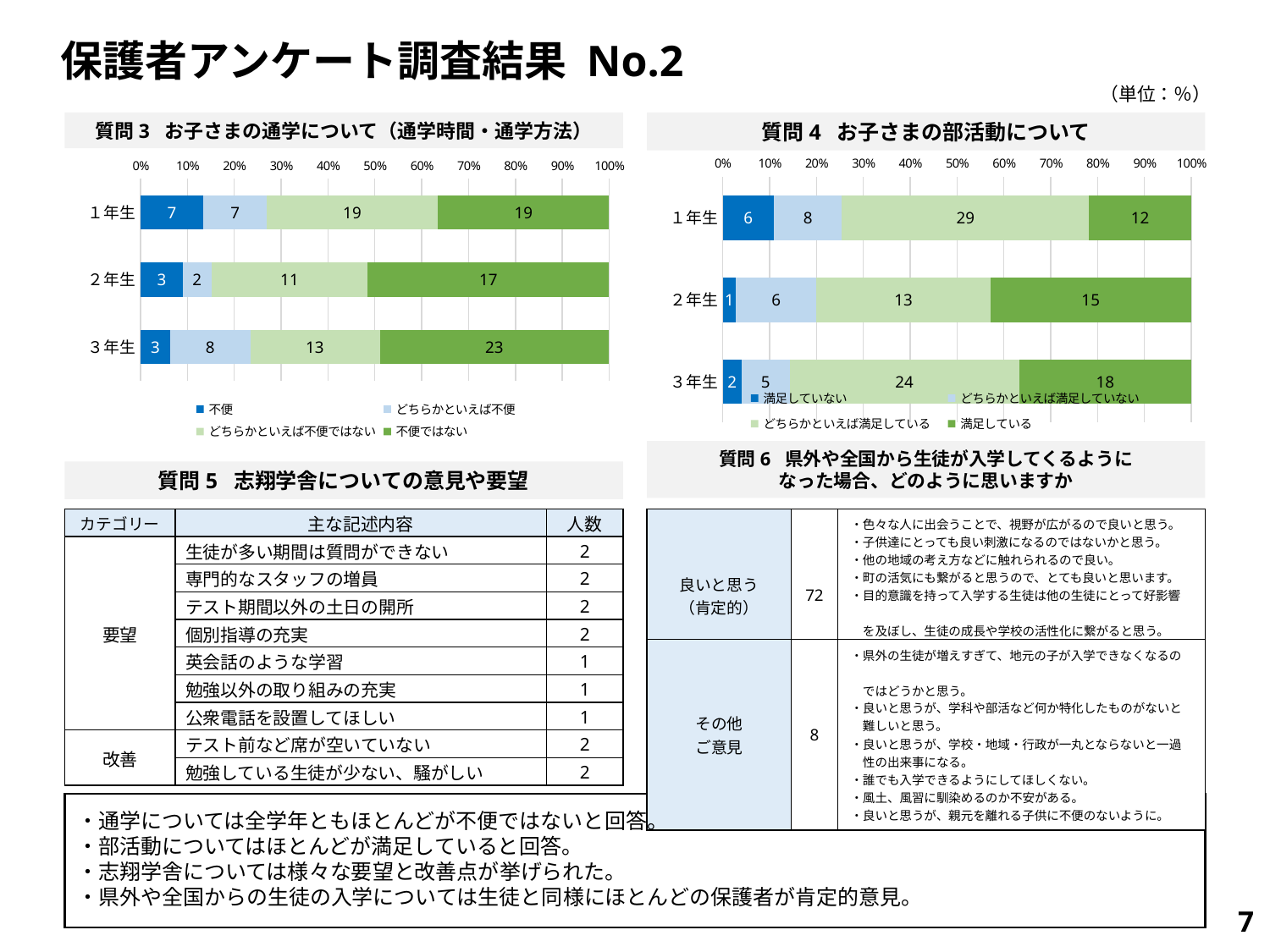
In the 質問3 chart, how many series does the legend list? 4 In the 質問4 chart, what is the value of どちらかといえば満足している for 1年生? 29 In the 質問4 chart, how many grade categories are plotted? 3 In the 質問4 chart, what is the difference between the 満足している values for 3年生 and 1年生? 6 In the 質問4 chart, which is larger for 2年生: どちらかといえば満足している or 満足している? 満足している In the 質問4 chart, which grade has the highest value for 満足している? 3年生 In the 質問3 chart, what is the value of 不便ではない for 1年生? 19 In the 質問4 chart, what is the value of 満足していない for 2年生? 1 In the 質問3 chart, which grade has the lowest value for どちらかといえば不便? 2年生 In the 質問3 chart, what is the total of the labelled values in the 2年生 bar? 33 In the 質問3 chart, what kind of chart is shown? Stacked bar chart In the 質問3 chart, what is the value of どちらかといえば不便 for 3年生? 8